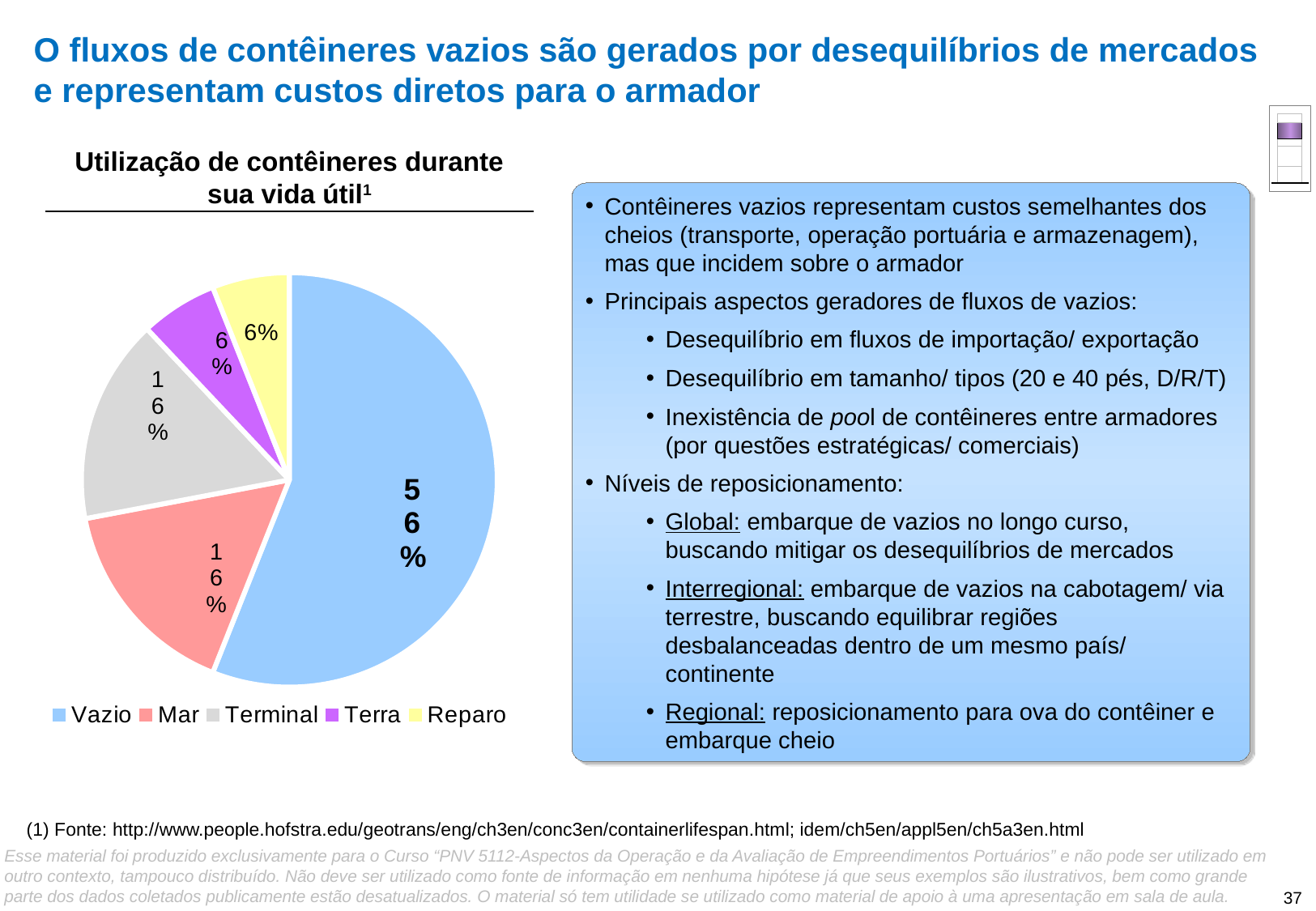
What kind of chart is shown on the slide? pie chart What is the difference in percentage points between the Vazio slice and the Mar slice? 40 Which category has the largest slice of the pie? Vazio What percentage of the pie is labelled for Vazio? 56% Which slice is larger, Vazio or Terminal? Vazio What percentage of the pie is labelled for Terminal? 16% What is the title of the chart? Utilização de contêineres durante sua vida útil What percentage of the pie is labelled for Terra? 6% What percentage of the pie is labelled for Reparo? 6% How many categories does the legend list? 5 What percentage of the pie is labelled for Mar? 16% What colour is the Vazio slice in the pie chart? light blue